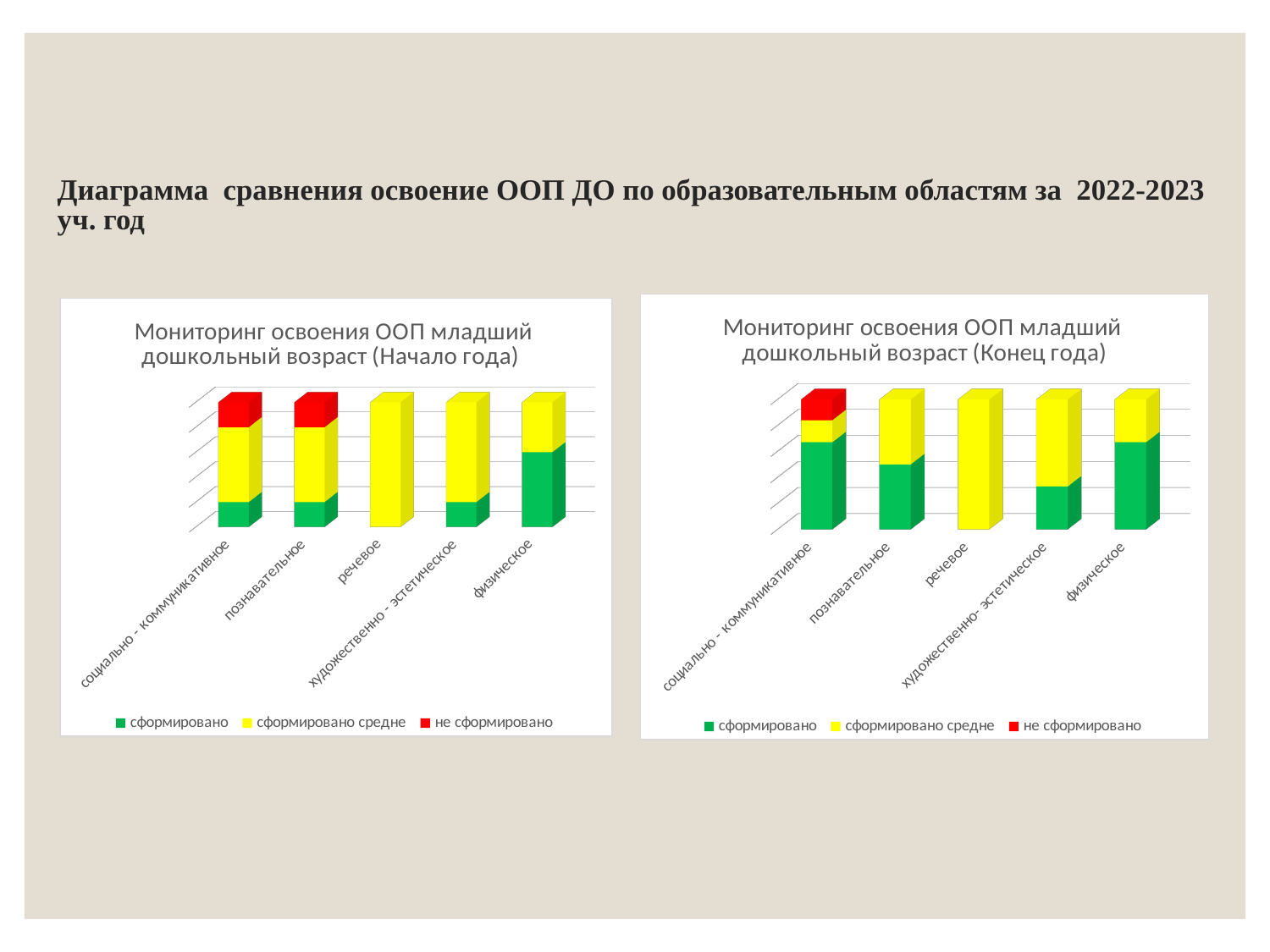
How many categories are shown on the x axis of the left chart (Начало года)? 5 In the left chart (Начало года), which category has the largest 'сформировано' (green) segment? физическое In the right chart (Конец года), which category has the largest 'сформировано' (green) segment? социально - коммуникативное and физическое (tied) What is the title of the right chart? Мониторинг освоения ООП младший дошкольный возраст (Конец года) In the right chart (Конец года), which has the larger 'сформировано' (green) segment: познавательное or художественно-эстетическое? познавательное In the right chart (Конец года), which category has no 'сформировано' (green) segment at all? речевое What are the legend entries of the left chart (Начало года)? сформировано, сформировано средне, не сформировано What kind of chart is the left chart, 'Мониторинг освоения ООП младший дошкольный возраст (Начало года)'? Stacked bar chart In the right chart (Конец года), how many categories have a red 'не сформировано' segment? 1 In the left chart (Начало года), which has the larger 'сформировано' (green) segment: физическое or познавательное? физическое How many series does the legend of the right chart (Конец года) list? 3 In the left chart (Начало года), how many categories have a red 'не сформировано' segment? 2